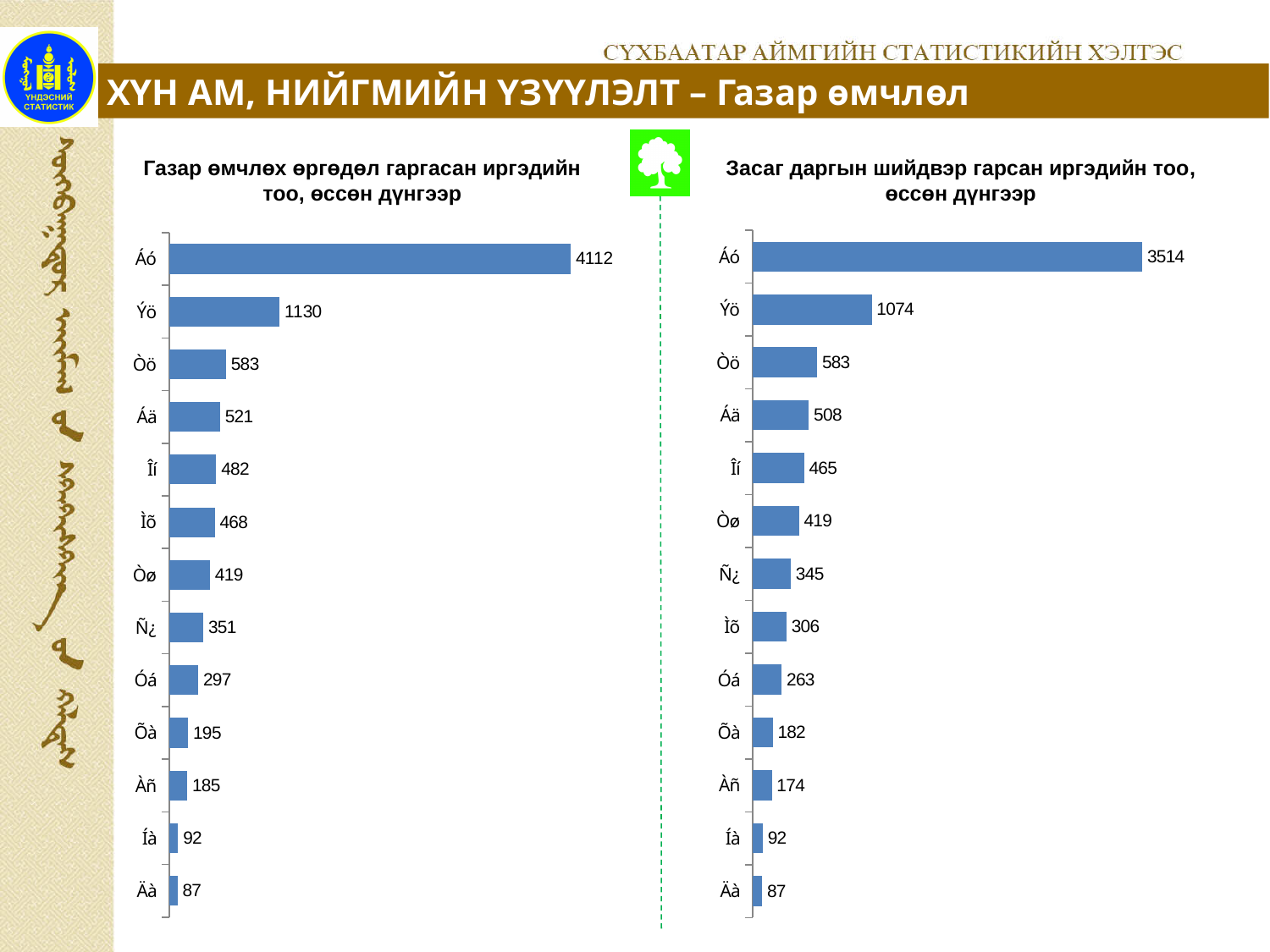
What is the title of the right chart on the slide? Засаг даргын шийдвэр гарсан иргэдийн тоо, өссөн дүнгээр In the left chart (Газар өмчлөх өргөдөл гаргасан иргэдийн тоо), what is the difference between the values for Áó and Ýö? 2982 In the right chart (Засаг даргын шийдвэр гарсан иргэдийн тоо), what is the difference between the values for Òö and Áä? 75 In the left chart (Газар өмчлөх өргөдөл гаргасан иргэдийн тоо), what is the value for Áó? 4112 In the left chart (Газар өмчлөх өргөдөл гаргасан иргэдийн тоо), which category has the highest value? Áó In the left chart (Газар өмчлөх өргөдөл гаргасан иргэдийн тоо), what is the value for Õà? 195 In the right chart (Засаг даргын шийдвэр гарсан иргэдийн тоо), what is the value for Ýö? 1074 In the left chart (Газар өмчлөх өргөдөл гаргасан иргэдийн тоо), which is larger, the value for Òø or the value for Ñ¿? Òø In the right chart (Засаг даргын шийдвэр гарсан иргэдийн тоо), which category has the lowest value? Äà In the right chart (Засаг даргын шийдвэр гарсан иргэдийн тоо), what is the value for Ìõ? 306 What type of chart is the left chart (Газар өмчлөх өргөдөл гаргасан иргэдийн тоо)? Bar chart How many categories are shown in the right chart (Засаг даргын шийдвэр гарсан иргэдийн тоо)? 13